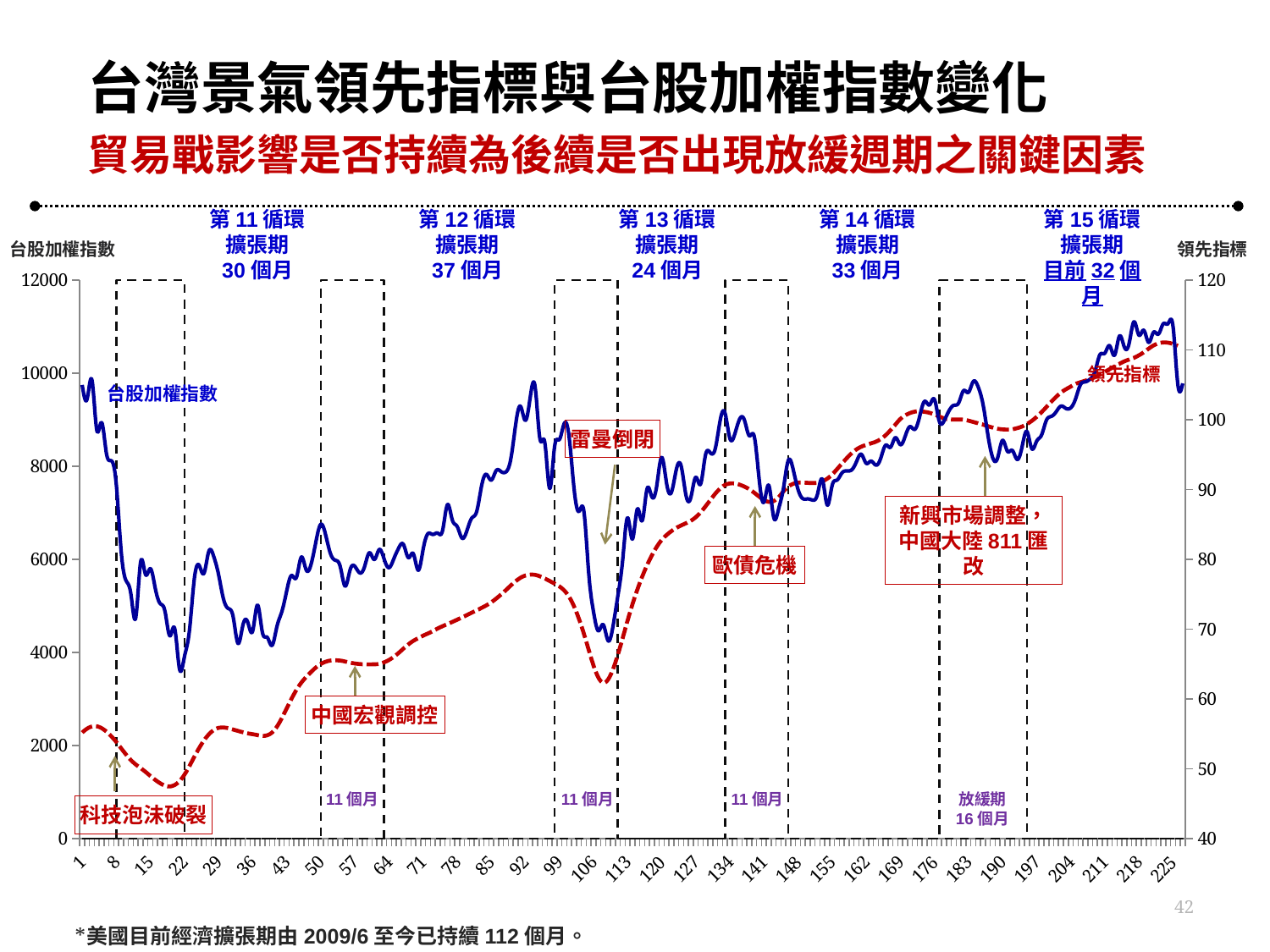
Does 台股加權指數 rise or fall between month 1 and month 22? fall How many data series are plotted on the chart? 2 Is the value of 領先指標 at month 1 greater or less than 60? less What kind of chart is shown on the slide? line chart Which is larger, 台股加權指數 at month 92 or at month 106? month 92 Which series is drawn as a red dashed line? 領先指標 Is the highest value of 台股加權指數 on the chart greater or less than 10000? greater Is the value of 領先指標 at month 106 greater or less than 70? less What is the title of the slide's chart? 台灣景氣領先指標與台股加權指數變化 Does 領先指標 rise or fall between month 148 and month 176? rise According to the chart annotation, how many months did the 第 12 循環 擴張期 last? 37 個月